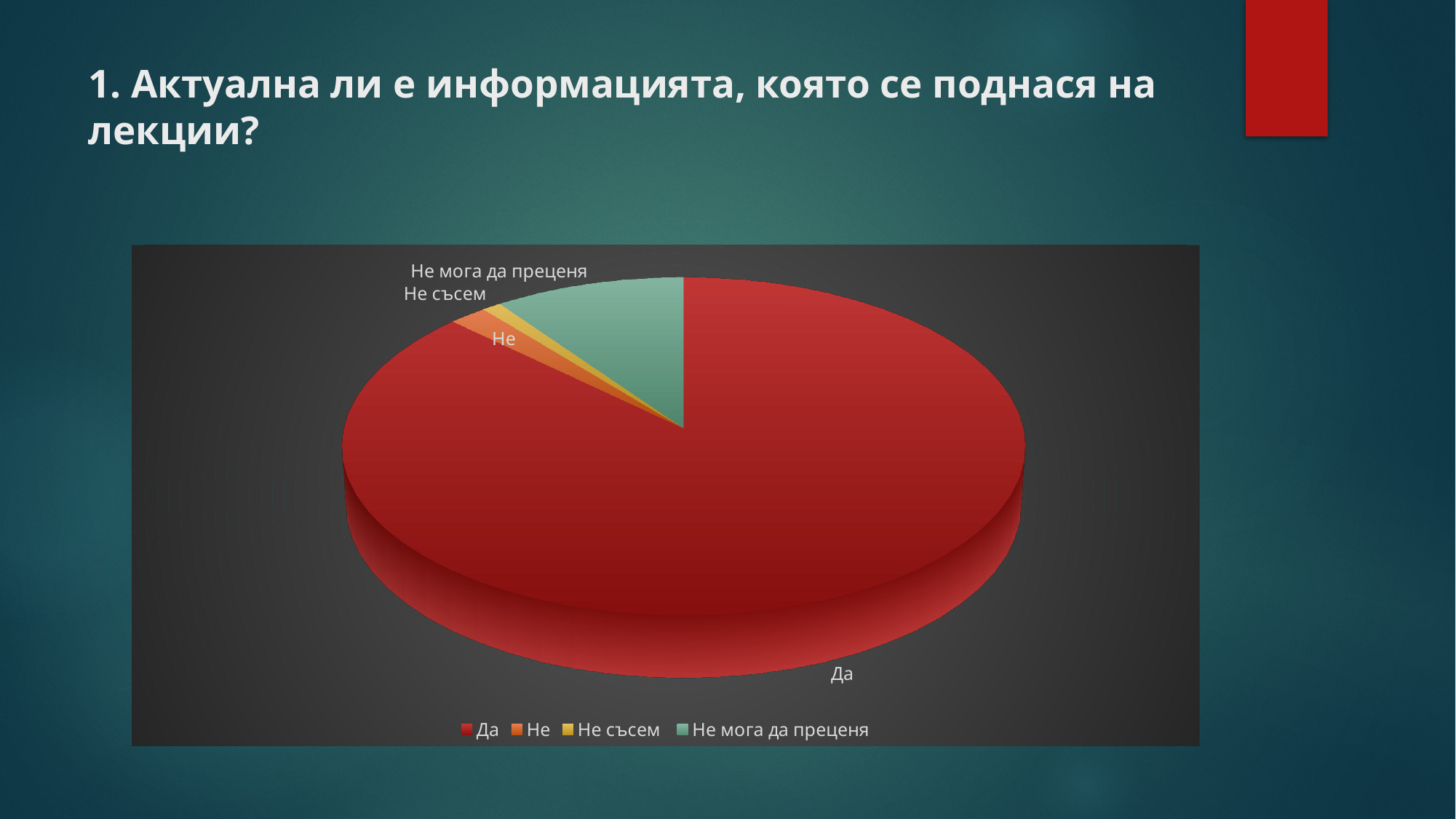
What kind of chart is shown on the slide? pie chart How many slices does the pie chart have? 4 What is the title of the slide containing the pie chart? 1. Актуална ли е информацията, която се поднася на лекции? Which slice is larger, "Да" or "Не мога да преценя"? Да Which category is the second largest slice in the pie chart? Не мога да преценя Which slice is larger, "Не мога да преценя" or "Не"? Не мога да преценя How many entries does the legend of the pie chart list? 4 What colour is the "Да" slice in the pie chart? red Which category has the largest slice in the pie chart? Да